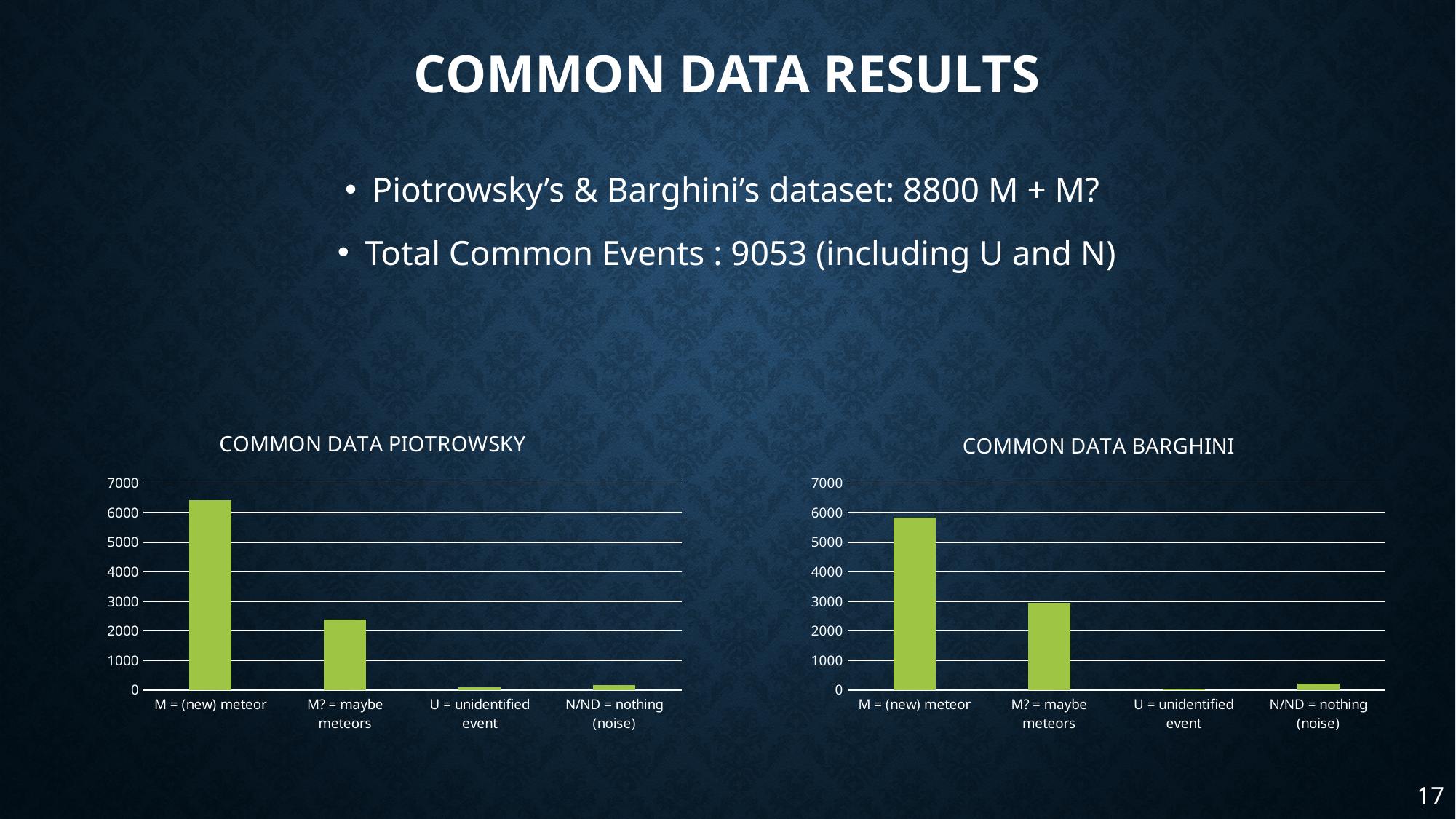
In the "Common Data Piotrowsky" chart, is the value for M = (new) meteor greater or less than 6000? greater In the "Common Data Barghini" chart, is the value for M = (new) meteor greater or less than 6000? less In the "Common Data Piotrowsky" chart, is the value for M? = maybe meteors greater or less than 3000? less In the "Common Data Piotrowsky" chart, which category has the highest value? M = (new) meteor Which chart shows a larger value for M = (new) meteor, "Common Data Piotrowsky" or "Common Data Barghini"? Common Data Piotrowsky What is the title of the chart on the right side of the slide? Common Data Barghini In the "Common Data Barghini" chart, which category has the highest value? M = (new) meteor What kind of chart is the "Common Data Piotrowsky" chart? bar chart How many categories are shown on the x axis of the "Common Data Barghini" chart? 4 Which chart shows a larger value for M? = maybe meteors, "Common Data Piotrowsky" or "Common Data Barghini"? Common Data Barghini In the "Common Data Barghini" chart, which category has the lowest value? U = unidentified event